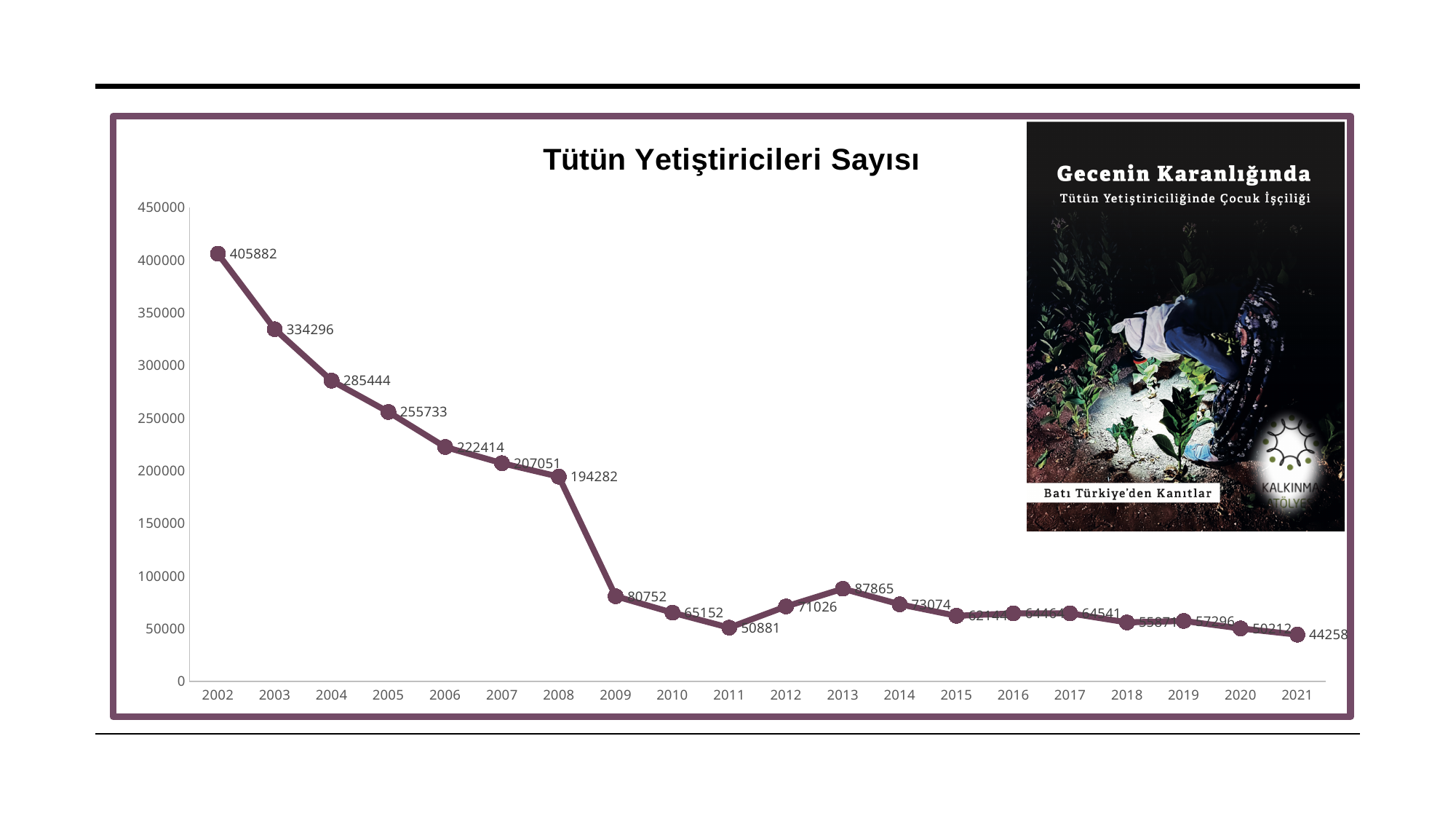
How many years are plotted on the x axis? 20 What is the difference between the values for 2002 and 2003? 71586 What is the value for 2009? 80752 What is the difference between the values for 2008 and 2009? 113530 What is the title of the chart? Tütün Yetiştiricileri Sayısı What is the value for 2002? 405882 Is the value for 2016 greater or less than 50000? greater Which year has the highest value? 2002 Which is larger, the value for 2012 or the value for 2013? 2013 What is the value for 2021? 44258 What kind of chart is shown on the slide? line chart Which year has the lowest value? 2021